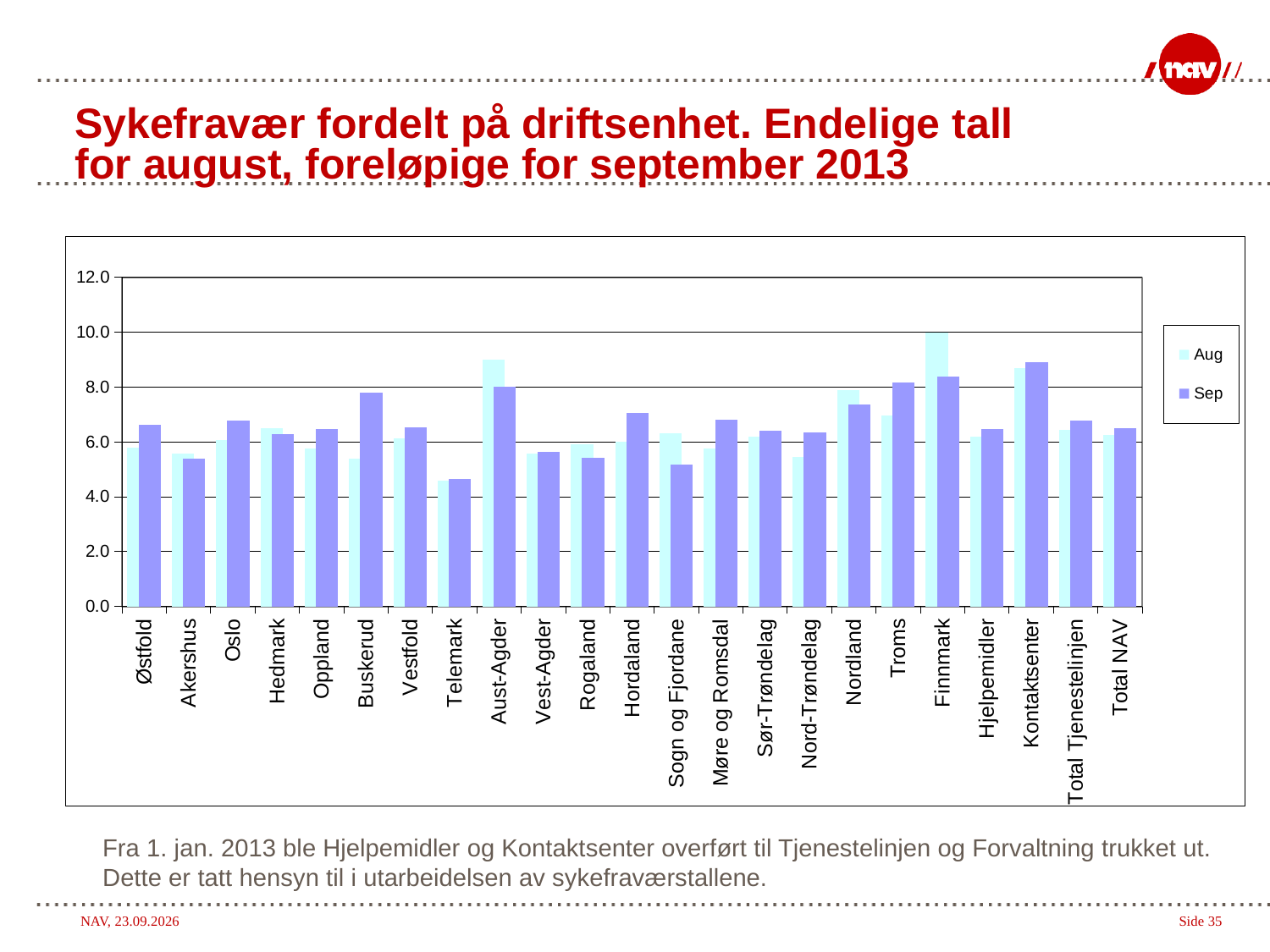
How many categories are shown along the x axis? 23 Which category has the lowest Aug value? Telemark What kind of chart is shown on the slide? bar chart Is the Sep value for Buskerud greater or less than 6.0? greater Which series is shown in the darker purple bars? Sep For Buskerud, which is larger, the Aug value or the Sep value? Sep How many series does the legend list? 2 For Aust-Agder, which is larger, the Aug value or the Sep value? Aug Which category has the highest Sep value? Kontaktsenter Which category has the highest Aug value? Finnmark Is the Aug value for Finnmark greater or less than 8.0? greater Is the Sep value for Telemark greater or less than 6.0? less